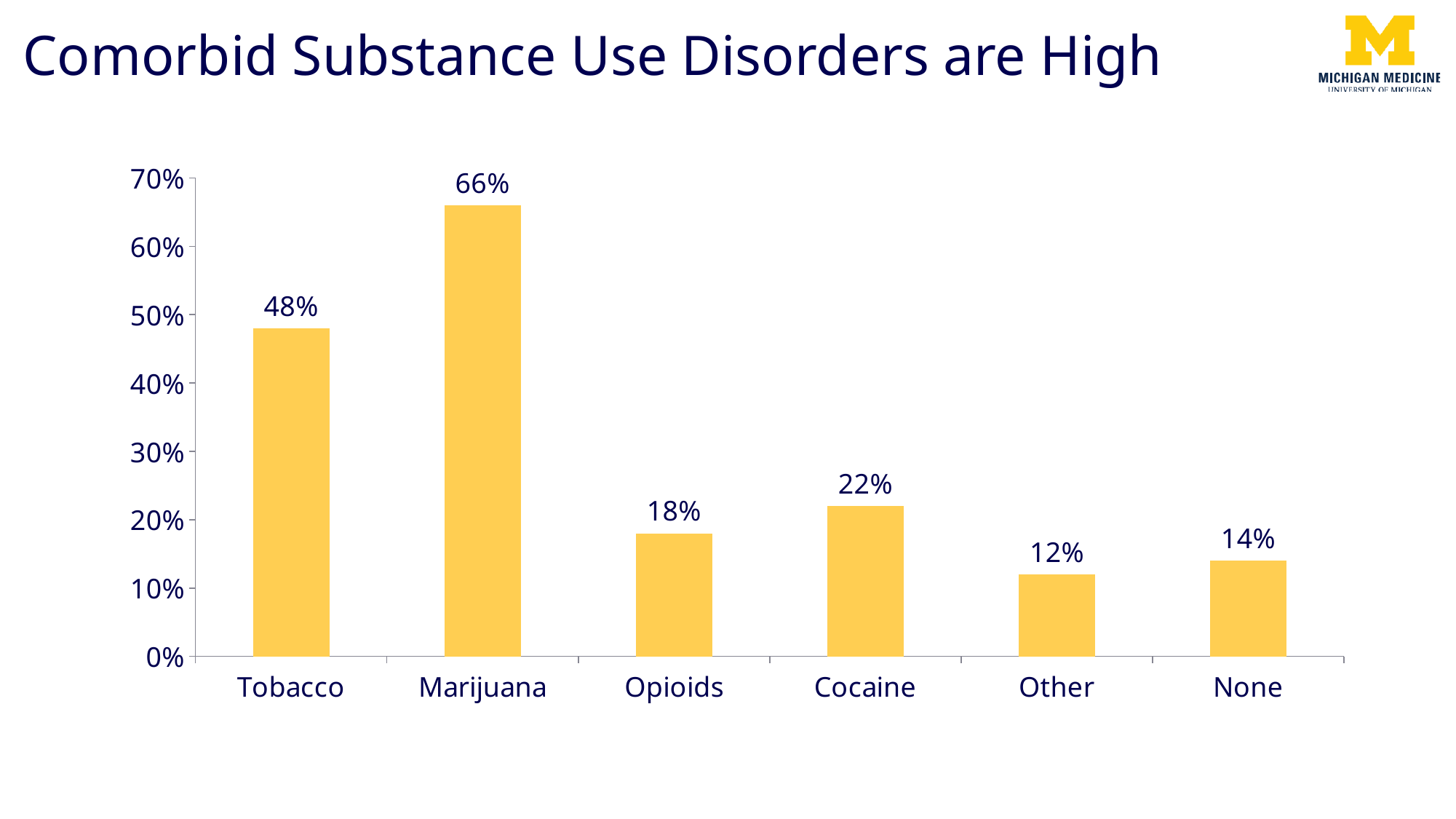
What is the difference between the values for Marijuana and Tobacco? 18% Is the value for Tobacco greater or less than 40%? greater Which category has the highest value? Marijuana What is the value for Opioids? 18% Which is larger, the value for Cocaine or the value for None? Cocaine How many categories are shown on the x axis? 6 What is the difference between the values for Cocaine and Opioids? 4% Which category has the lowest value? Other What kind of chart is shown on the slide? Bar chart What is the value for None? 14% What is the value for Tobacco? 48% What is the value for Marijuana? 66%